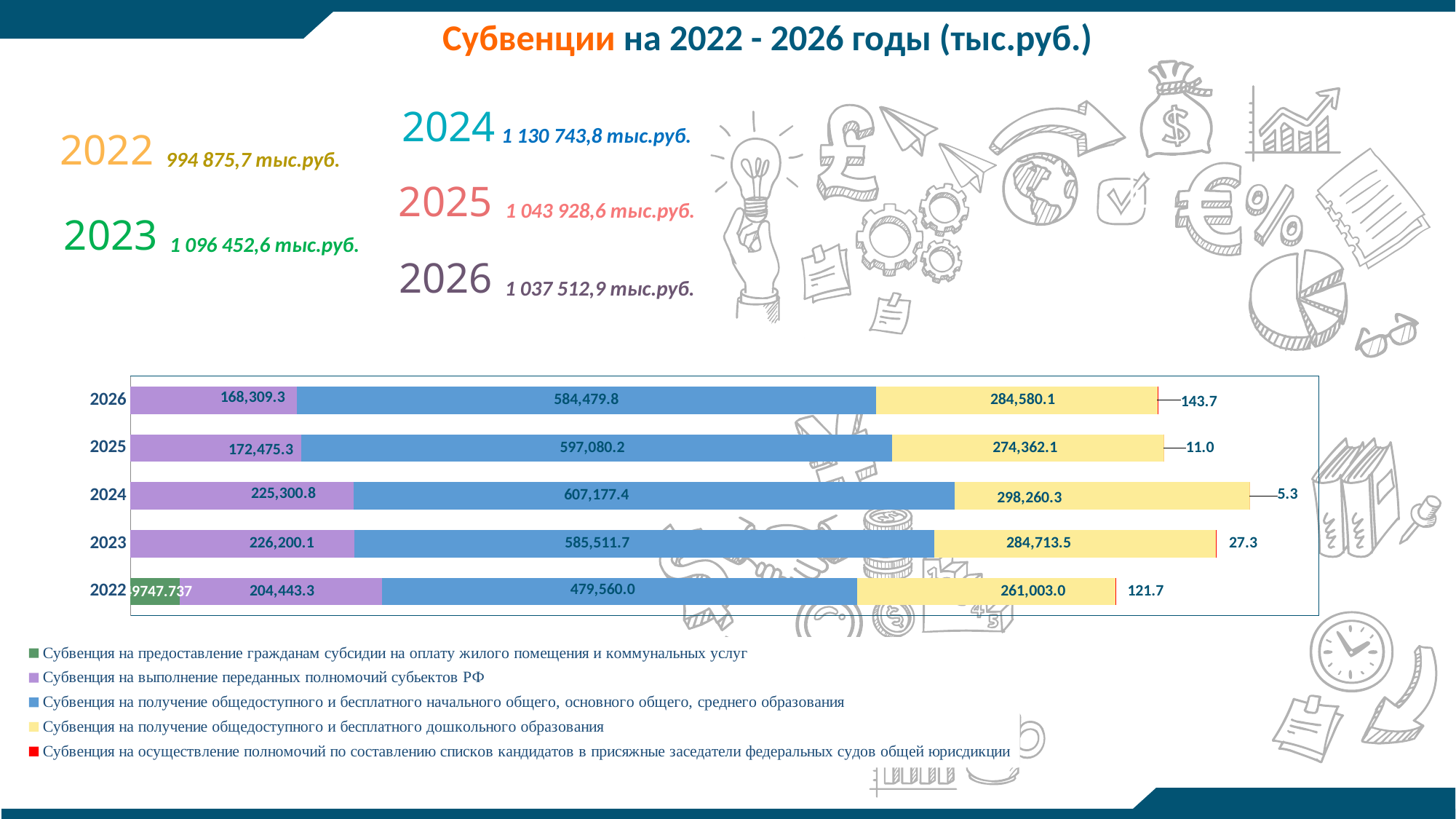
What is the value of the purple series (Субвенция на выполнение переданных полномочий субъектов РФ) for 2026? 168,309.3 In which year is the red series (списков кандидатов в присяжные заседатели) lowest? 2024 What kind of chart is shown on the slide? Stacked horizontal bar chart How many years (categories) are shown in the chart? 5 What is the difference between the blue series values for 2024 and 2025? 10,097.2 What is the value of the blue series (Субвенция на получение общедоступного и бесплатного начального общего, основного общего, среднего образования) for 2024? 607,177.4 How many series does the legend list? 5 Which colour represents Субвенция на получение общедоступного и бесплатного дошкольного образования in the legend? Yellow What is the value of the yellow series (Субвенция на получение общедоступного и бесплатного дошкольного образования) for 2022? 261,003.0 In which year is the blue series (начального общего, основного общего, среднего образования) highest? 2024 Which is larger: the purple series value for 2023 or for 2026? 2023